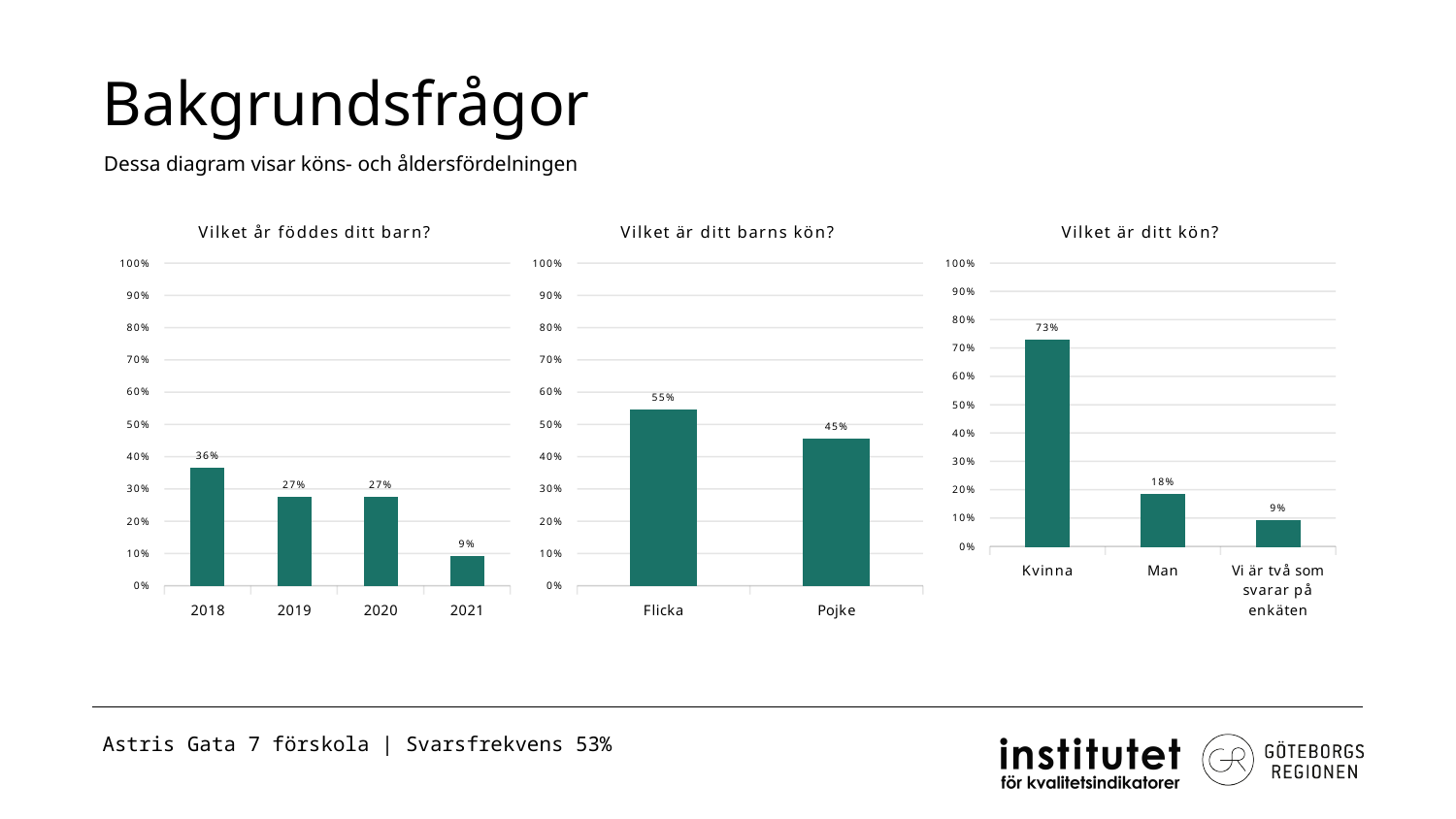
In the chart 'Vilket är ditt barns kön?', what is the value for Pojke? 45% What kind of chart is 'Vilket är ditt kön?'? Bar chart In the chart 'Vilket år föddes ditt barn?', what is the value for 2018? 36% In the chart 'Vilket är ditt kön?', what is the value for 'Vi är två som svarar på enkäten'? 9% In the chart 'Vilket är ditt kön?', what is the value for Man? 18% In the chart 'Vilket är ditt barns kön?', what is the difference between Flicka and Pojke? 10% In the chart 'Vilket år föddes ditt barn?', what is the difference between the values for 2018 and 2021? 27% In the chart 'Vilket är ditt barns kön?', which category has the higher value, Flicka or Pojke? Flicka In the chart 'Vilket år föddes ditt barn?', which year has the lowest value? 2021 In the chart 'Vilket år föddes ditt barn?', do the values rise or fall from 2018 to 2021? Fall In the chart 'Vilket är ditt kön?', which category has the highest value? Kvinna In the chart 'Vilket år föddes ditt barn?', how many years are shown on the x axis? 4